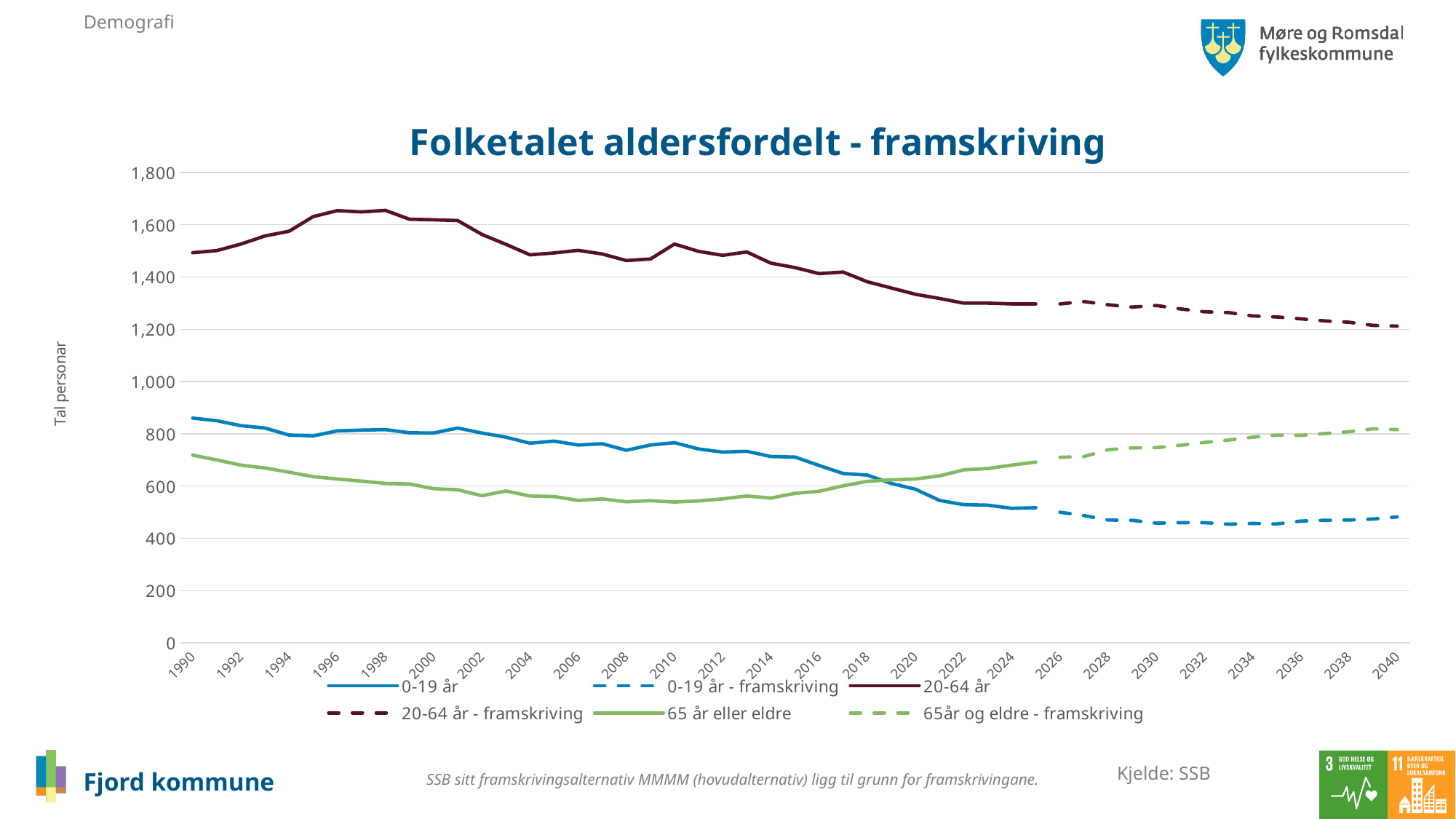
What is the title of the chart? Folketalet aldersfordelt - framskriving In 2040, which is higher: 0-19 år - framskriving or 65år og eldre - framskriving? 65år og eldre - framskriving Does the 20-64 år series rise or fall between 2000 and 2024? fall Is the value for 20-64 år in 1990 greater or less than 1,400? greater Which series has the highest values across the whole chart? 20-64 år Is the value for 0-19 år - framskriving in 2040 greater or less than 600? less What kind of chart is shown on the slide? line chart Does the 65år og eldre - framskriving series rise or fall between 2026 and 2040? rise How many series does the legend list? 6 What is the label on the vertical axis? Tal personar Is the value for 65 år eller eldre in 1990 greater or less than 800? less